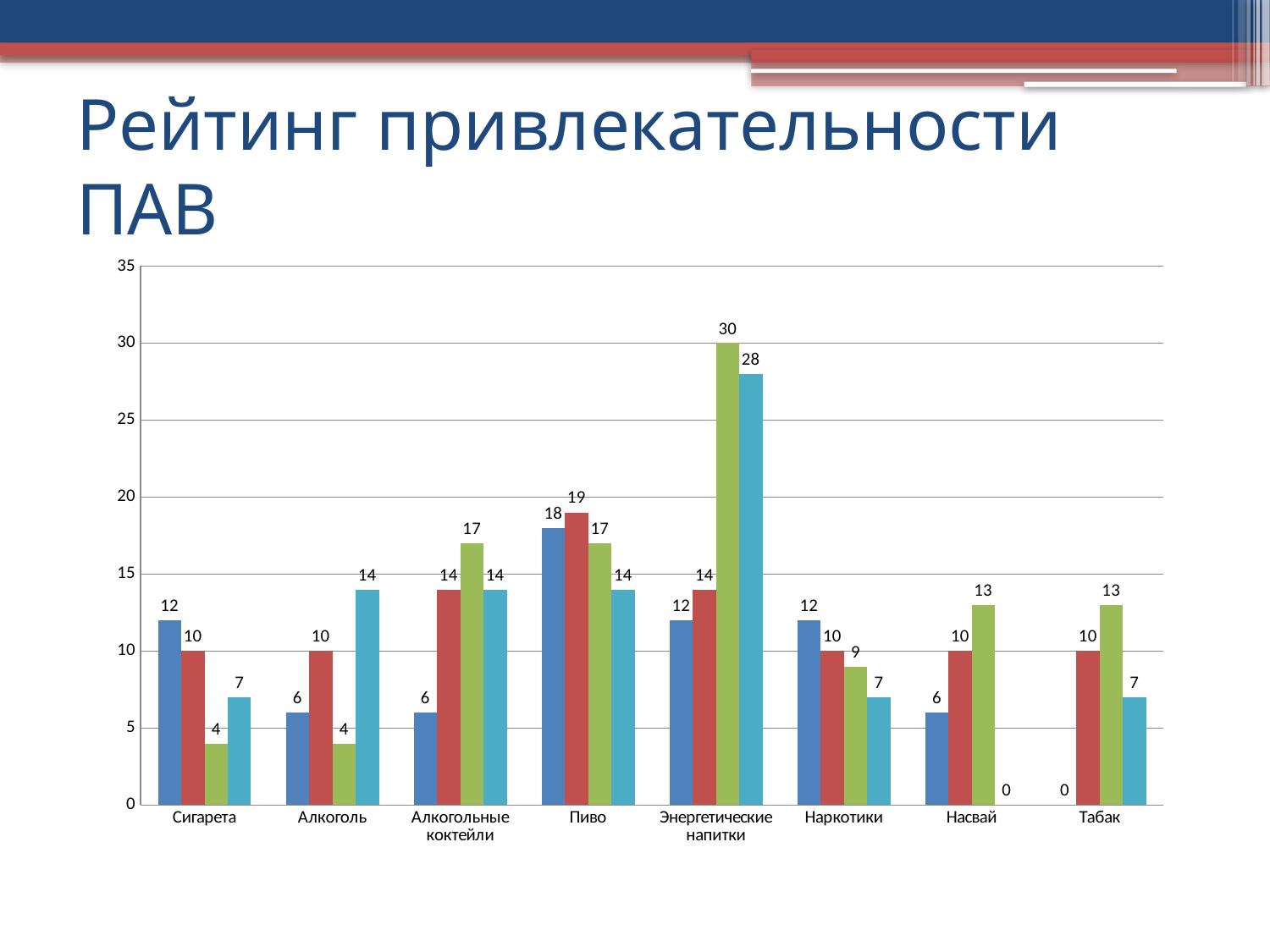
What is the difference between the green bar and the light blue bar for Энергетические напитки? 2 Which is larger for Алкоголь: the red bar or the light blue bar? the light blue bar What is the value of the red bar for Пиво? 19 Which category has the highest green bar? Энергетические напитки Which category has the lowest dark blue bar? Табак What is the value of the green bar for Табак? 13 What is the value of the green bar for Энергетические напитки? 30 What is the value of the light blue bar for Насвай? 0 What is the title of the slide containing the chart? Рейтинг привлекательности ПАВ How many categories are shown on the x axis of the chart? 8 What is the difference between the dark blue bar for Пиво and the dark blue bar for Сигарета? 6 What type of chart is shown on the slide? bar chart